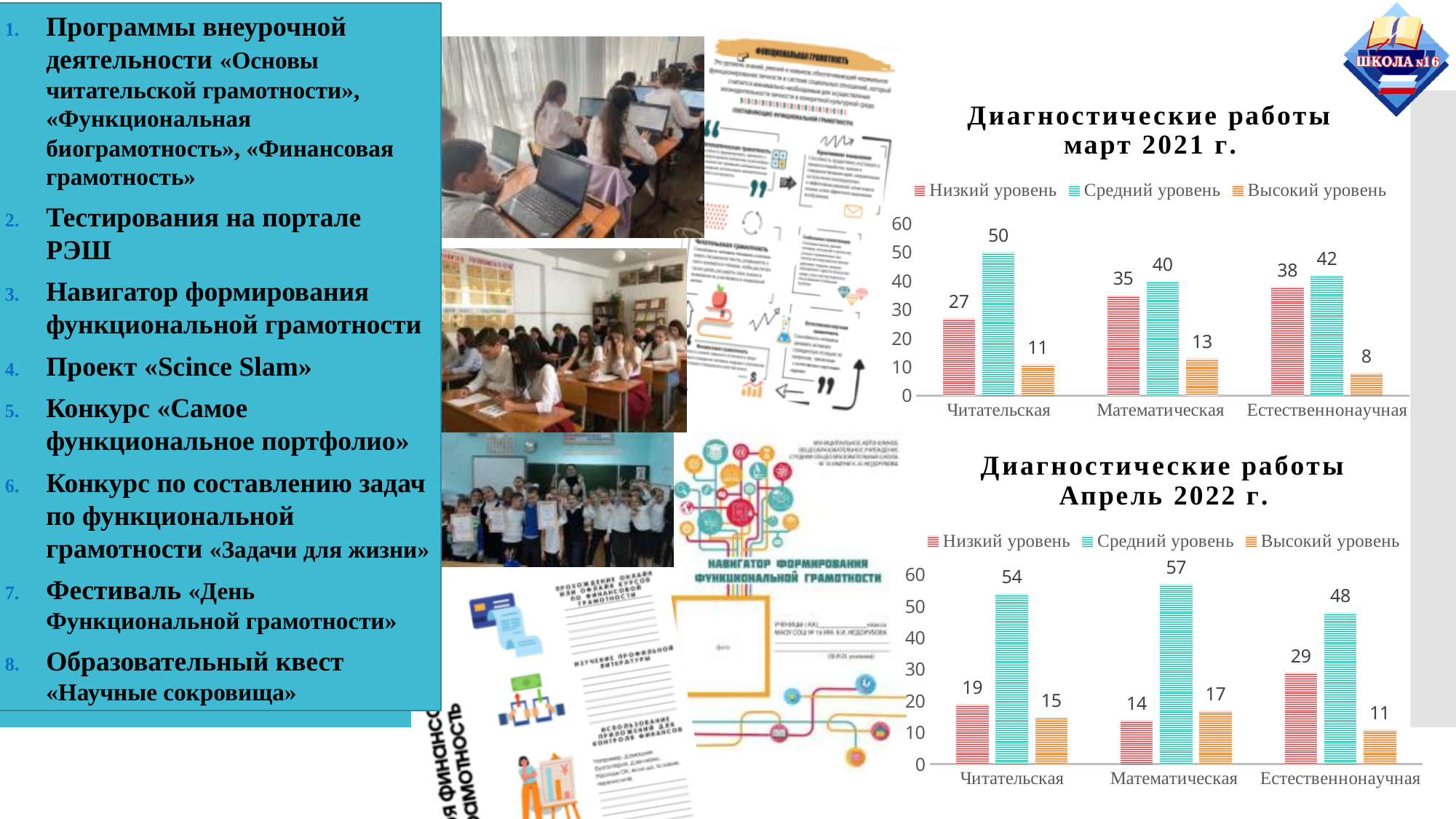
In the chart titled "Диагностические работы Апрель 2022 г.", what is the total of the three values in the Читательская category? 88 In the chart titled "Диагностические работы март 2021 г.", what is the value for Средний уровень in the Читательская category? 50 How many series does the legend of the chart titled "Диагностические работы Апрель 2022 г." list? 3 What kind of chart is the chart titled "Диагностические работы март 2021 г."? Bar chart In the chart titled "Диагностические работы март 2021 г.", which category has the lowest value for Низкий уровень? Читательская In the chart titled "Диагностические работы Апрель 2022 г.", what is the difference between Средний уровень and Низкий уровень in the Естественнонаучная category? 19 In the chart titled "Диагностические работы Апрель 2022 г.", which category has the highest value for Средний уровень? Математическая How many categories are shown on the x axis of the chart titled "Диагностические работы март 2021 г."? 3 In the chart titled "Диагностические работы Апрель 2022 г.", is the value for Средний уровень in the Читательская category greater or less than 50? greater In the chart titled "Диагностические работы март 2021 г.", which is larger in the Математическая category: Низкий уровень or Высокий уровень? Низкий уровень In the chart titled "Диагностические работы март 2021 г.", what is the value for Высокий уровень in the Естественнонаучная category? 8 In the chart titled "Диагностические работы Апрель 2022 г.", what is the value for Низкий уровень in the Математическая category? 14